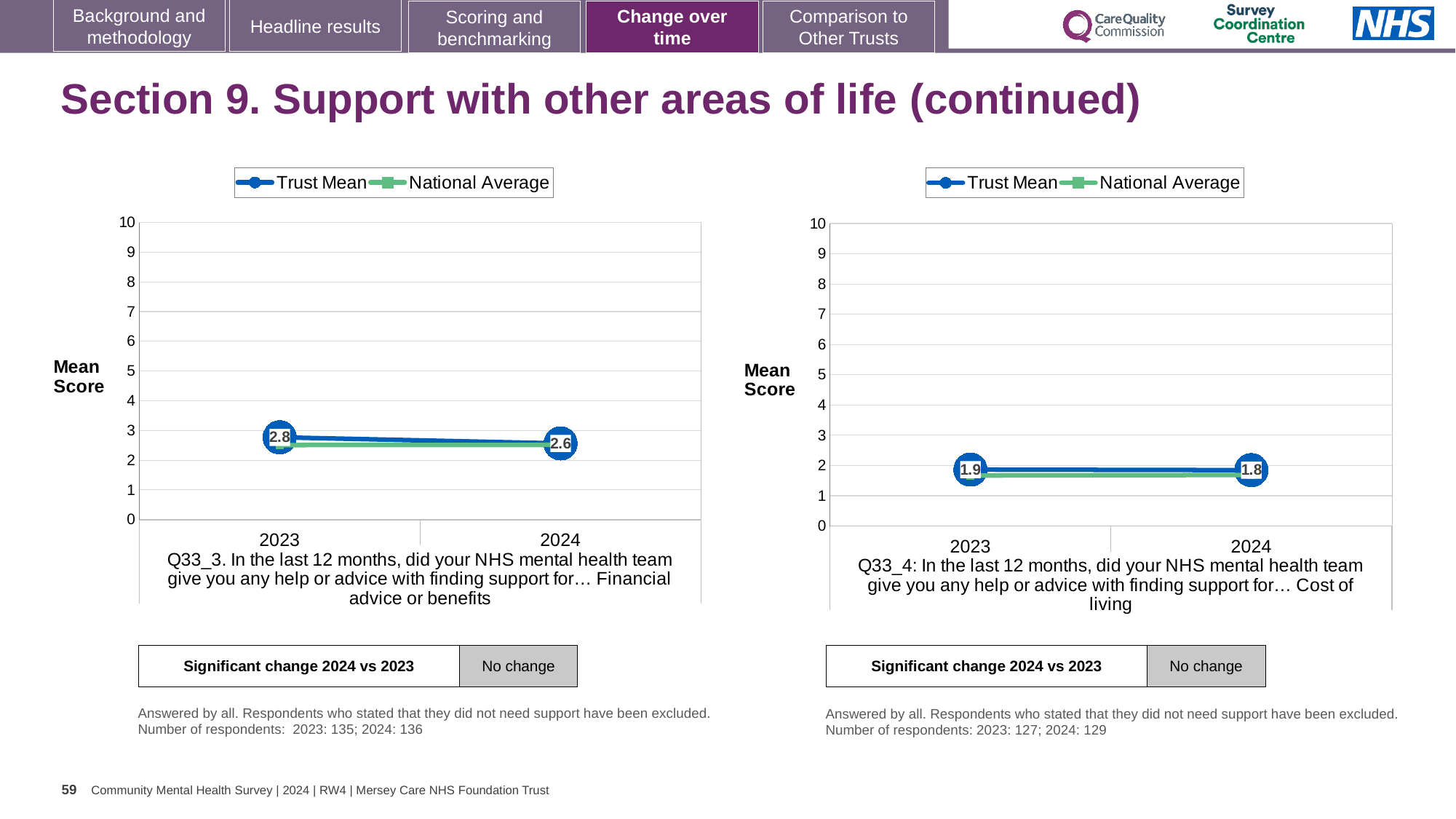
On the left chart (Q33_3), by how much did the Trust Mean change from 2023 to 2024? 0.2 What is the y-axis label on the left chart? Mean Score On the right chart (Q33_4, Cost of living), what is the Trust Mean score for 2024? 1.8 On the left chart (Q33_3, Financial advice or benefits), what is the Trust Mean score for 2024? 2.6 What kind of chart is the right chart (Q33_4)? line chart On the right chart (Q33_4), by how much did the Trust Mean change from 2023 to 2024? 0.1 How many years are plotted on the x axis of the right chart (Q33_4)? 2 How many series does the legend of the left chart list? 2 On the right chart (Q33_4, Cost of living), what is the Trust Mean score for 2023? 1.9 On the right chart (Q33_4), is the National Average value for 2024 greater or less than 3? less On the left chart (Q33_3), does the Trust Mean rise or fall from 2023 to 2024? fall On the left chart (Q33_3, Financial advice or benefits), what is the Trust Mean score for 2023? 2.8